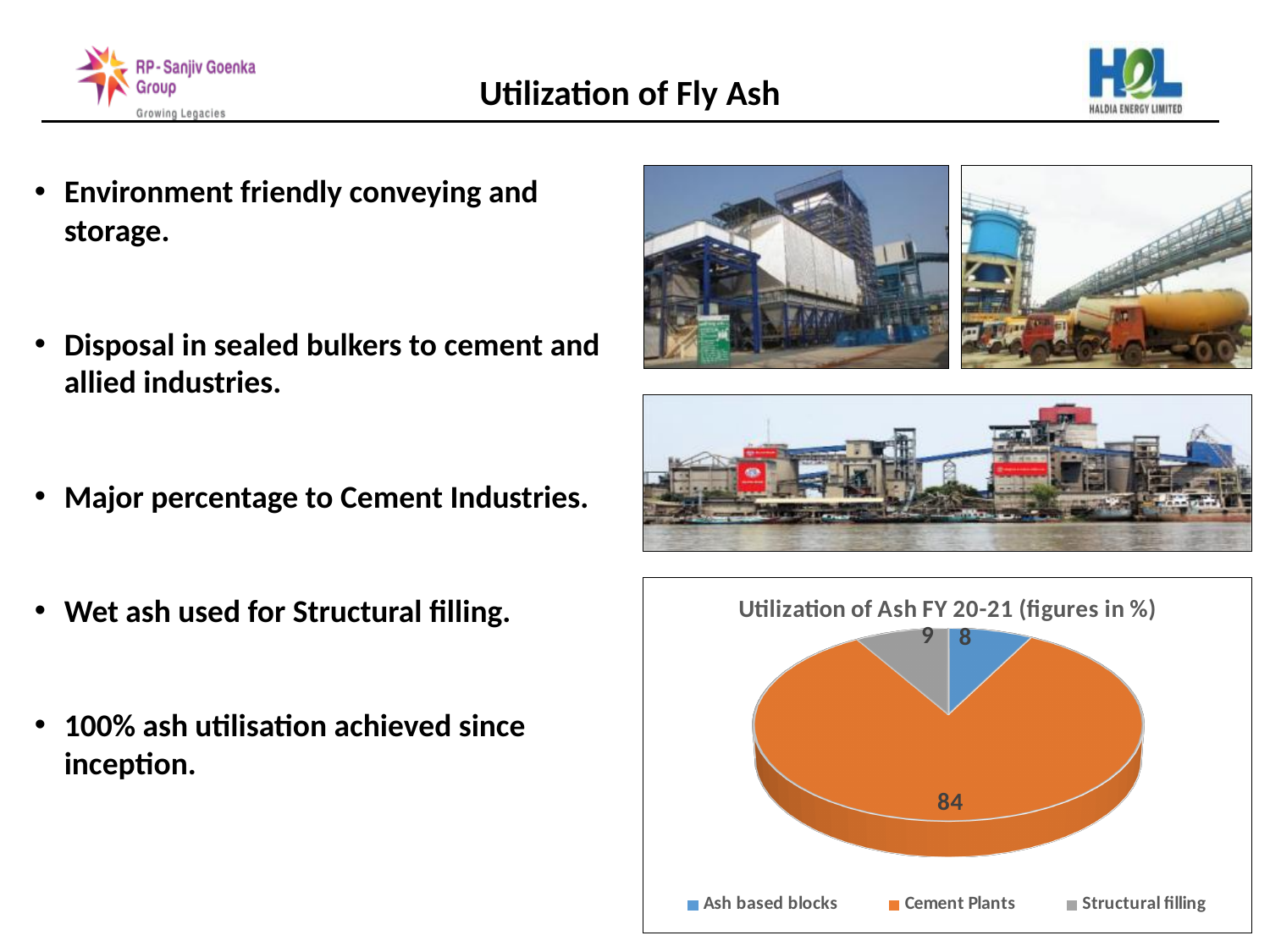
What is the difference between the values for Cement Plants and Structural filling? 75 Which category has the largest slice of the pie chart? Cement Plants What is the value for Structural filling in the pie chart? 9 What is the value for Cement Plants in the pie chart? 84 How many entries does the chart legend list? 3 How many categories does the pie chart show? 3 What is the value for Ash based blocks in the pie chart? 8 Which category has the smallest slice of the pie chart? Ash based blocks What kind of chart is shown on the slide? pie chart Which is larger, the value for Structural filling or the value for Ash based blocks? Structural filling Which colour represents Cement Plants in the pie chart? orange What is the title of the chart? Utilization of Ash FY 20-21 (figures in %)